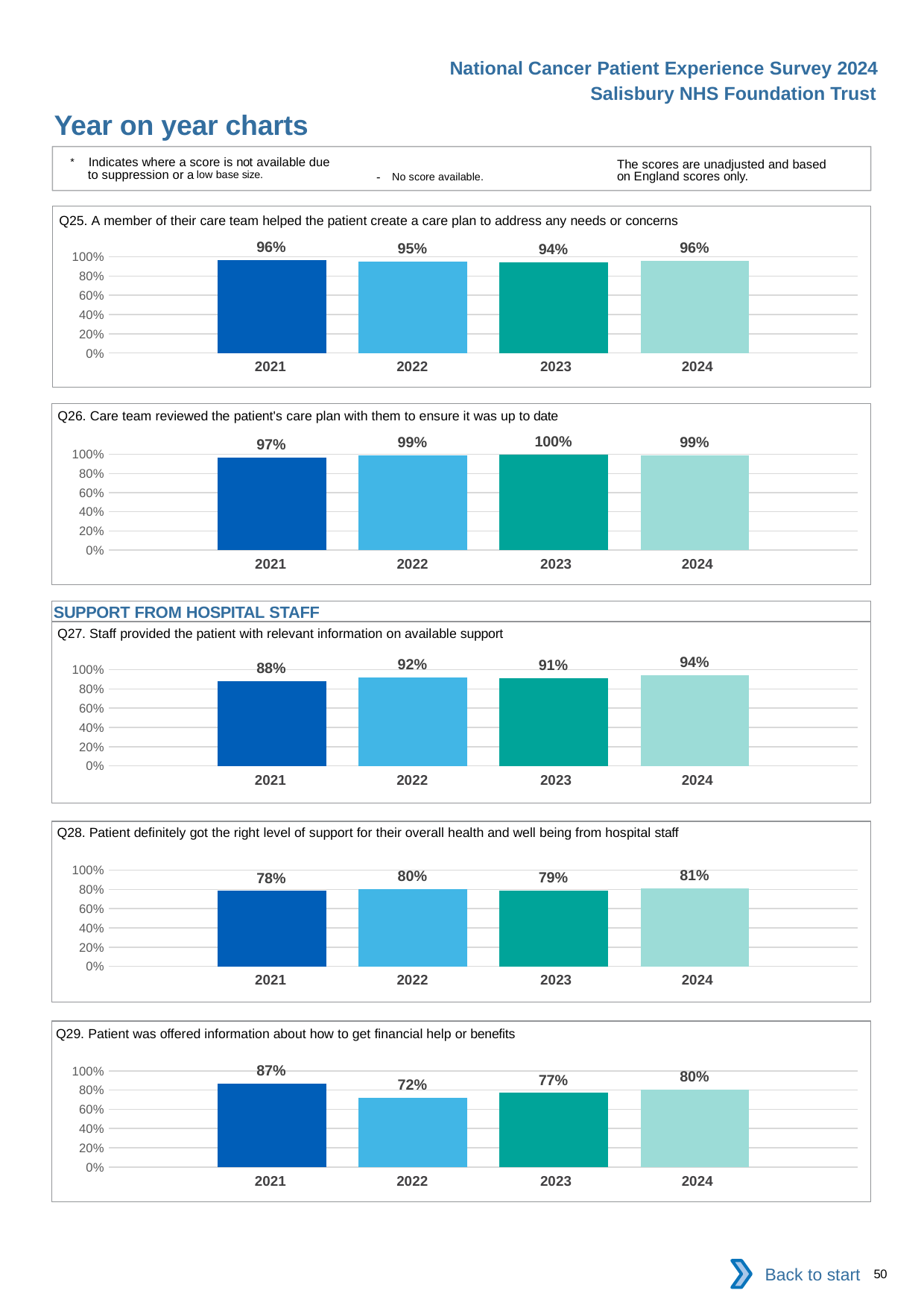
In the Q26 chart, which year has the highest value? 2023 In the Q28 chart, which is larger, the value for 2022 or the value for 2023? 2022 In the Q29 chart, which year has the lowest value? 2022 What type of chart is the Q25 chart? Bar chart In the Q25 chart, what is the value for 2023? 94% In the Q28 chart, what is the value for 2024? 81% In the Q27 chart, what is the difference between the 2024 and 2021 values? 6% In the Q29 chart, what is the difference between the 2021 and 2022 values? 15% How many years are shown in the Q29 chart? 4 In the Q27 chart, which year has the lowest value? 2021 What is the section heading shown above the Q27 chart? SUPPORT FROM HOSPITAL STAFF In the Q26 chart, what is the value for 2021? 97%